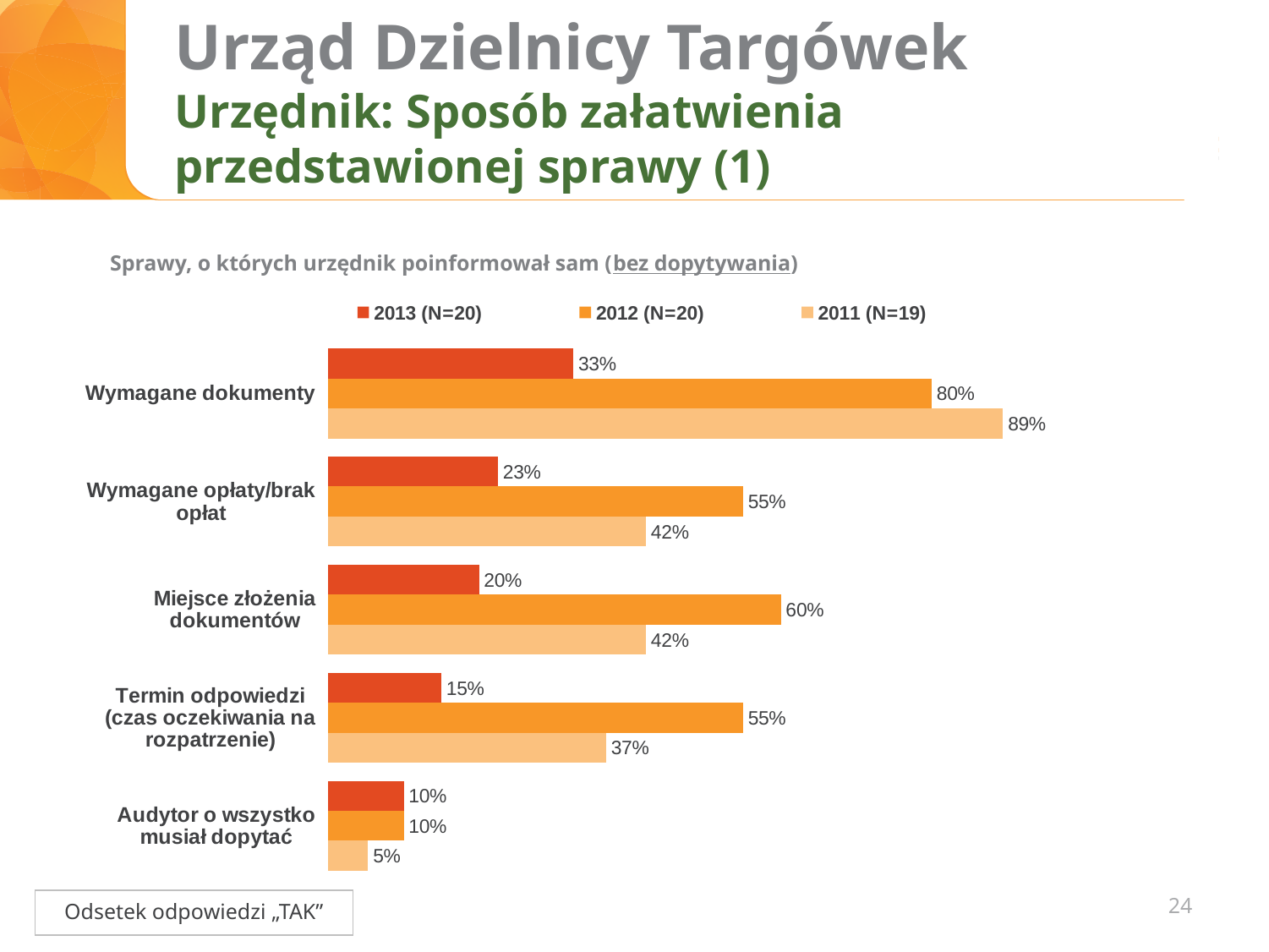
Which category has the highest value in the 2011 (N=19) series? Wymagane dokumenty What is the value for "Termin odpowiedzi (czas oczekiwania na rozpatrzenie)" in the 2011 (N=19) series? 37% What is the value for "Miejsce złożenia dokumentów" in the 2012 (N=20) series? 60% What is the value for "Wymagane dokumenty" in the 2013 (N=20) series? 33% What is the difference between the 2012 (N=20) and 2013 (N=20) values for "Wymagane dokumenty"? 47% What is the value for "Audytor o wszystko musiał dopytać" in the 2011 (N=19) series? 5% What is the subtitle shown above the chart? Sprawy, o których urzędnik poinformował sam (bez dopytywania) Which category has the lowest value in the 2013 (N=20) series? Audytor o wszystko musiał dopytać Which is larger for "Wymagane opłaty/brak opłat": the 2012 (N=20) value or the 2011 (N=19) value? 2012 (N=20) How many series does the legend list? 3 How many categories are shown on the chart? 5 What kind of chart is shown on the slide? Bar chart